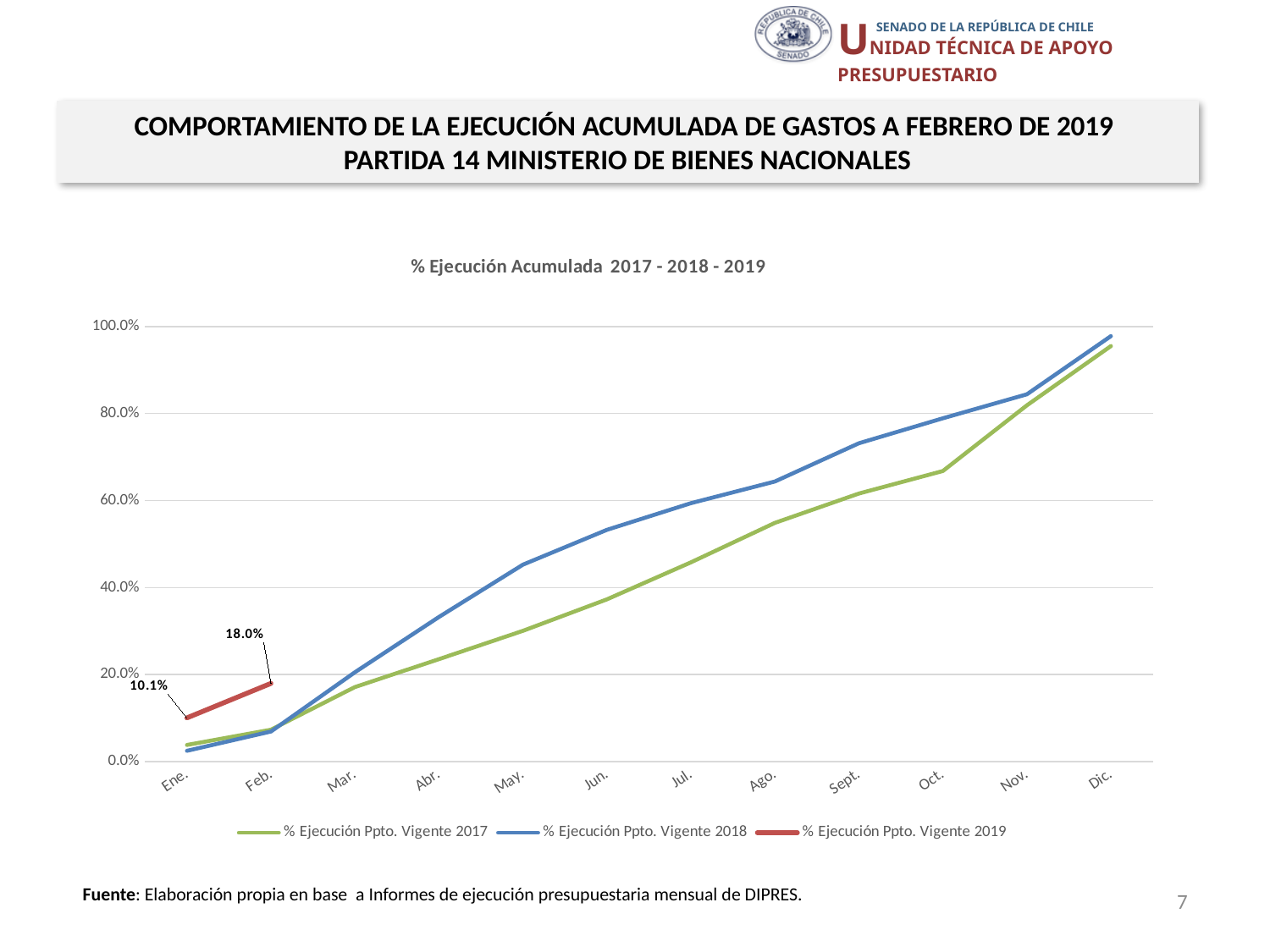
Is the value for % Ejecución Ppto. Vigente 2018 in Dic. greater or less than 80.0%? greater What is the value of % Ejecución Ppto. Vigente 2019 for Ene.? 10.1% How many series does the legend list? 3 What is the difference between the Feb. and Ene. values of % Ejecución Ppto. Vigente 2019? 7.9% In Jun., which series has the larger value: % Ejecución Ppto. Vigente 2017 or % Ejecución Ppto. Vigente 2018? % Ejecución Ppto. Vigente 2018 What kind of chart is shown on the slide? line chart In which month does % Ejecución Ppto. Vigente 2018 reach its highest value? Dic. What is the title of the chart? % Ejecución Acumulada 2017 - 2018 - 2019 What is the value of % Ejecución Ppto. Vigente 2019 for Feb.? 18.0% How many months are shown on the x axis? 12 Is the value for % Ejecución Ppto. Vigente 2017 in Oct. greater or less than 80.0%? less Does the % Ejecución Ppto. Vigente 2018 line rise or fall from Ene. to Dic.? rise